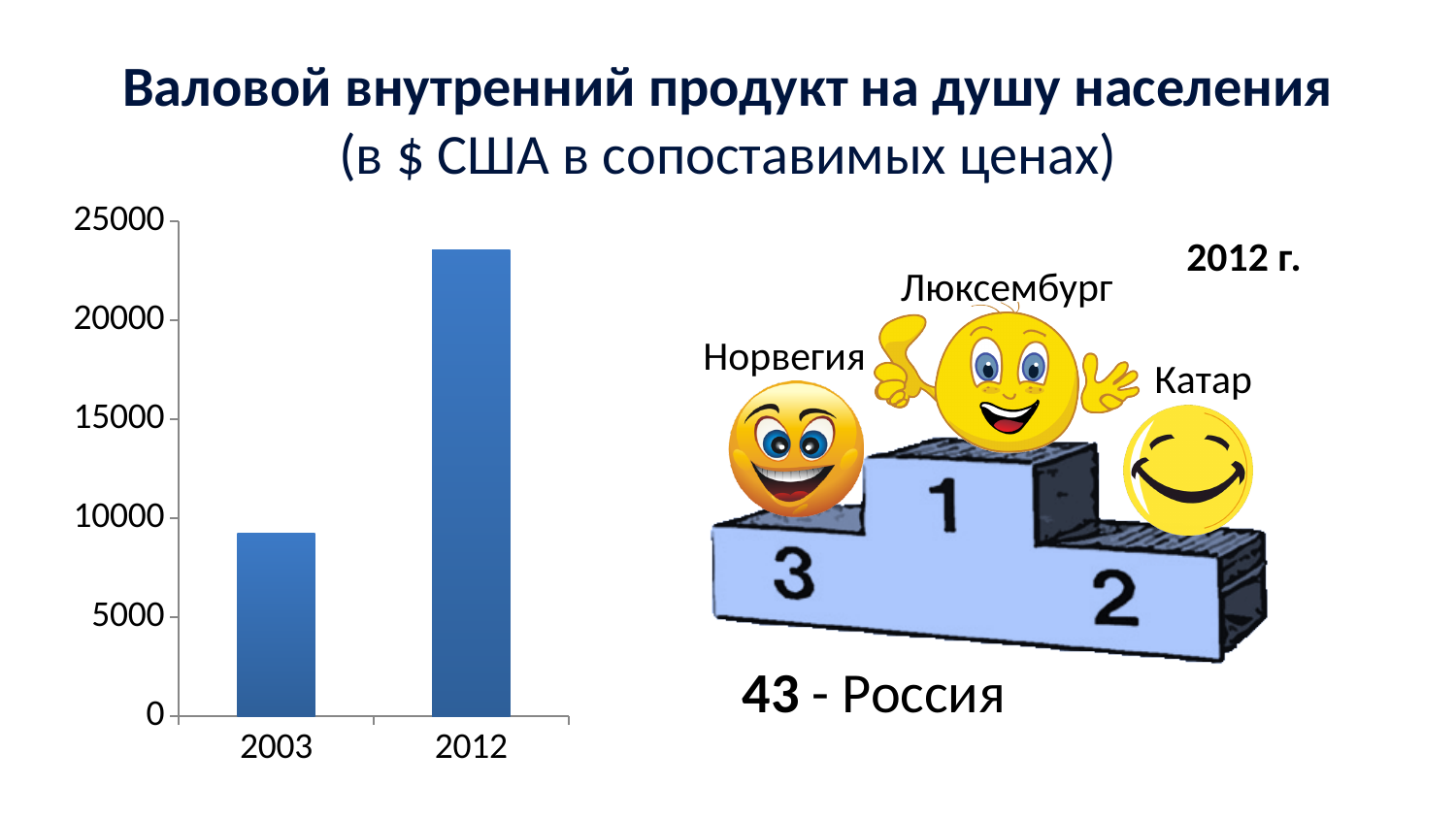
What is the highest value shown on the vertical axis of the chart? 25000 Is the value for 2003 greater or less than 10000? less Is the value for 2003 larger or smaller than the value for 2012? smaller Which year has the lower GDP per capita in the chart? 2003 What kind of chart is shown on the slide? bar chart Does the value rise or fall from 2003 to 2012? rise Is the value for 2012 greater or less than 25000? less How many bars does the chart show? 2 Which year has the higher GDP per capita in the chart? 2012 Is the value for 2012 greater or less than 20000? greater What is the title of the slide containing the chart? Валовой внутренний продукт на душу населения (в $ США в сопоставимых ценах)